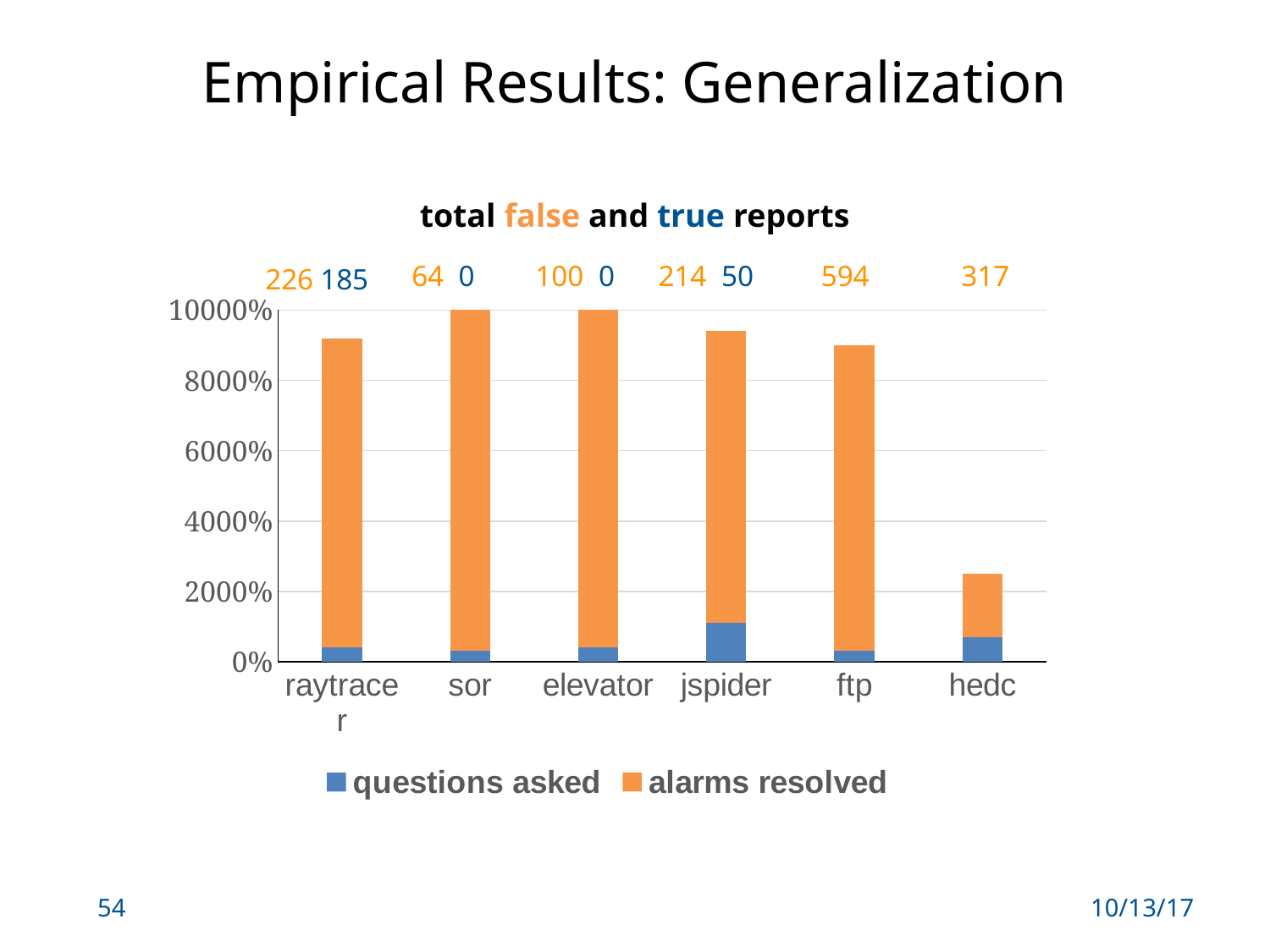
How many categories are shown on the x axis of the chart? 6 What number of false reports is printed above the raytracer bar? 226 What is the title of the chart? total false and true reports Which has the larger total bar, ftp or hedc? ftp Is the 'questions asked' segment for jspider greater or less than 2000%? less Which category has the lowest total bar in the chart? hedc Which has the larger 'questions asked' segment, jspider or raytracer? jspider Is the total bar for ftp greater or less than 8000%? greater Is the total bar for hedc greater or less than 4000%? less What kind of chart is shown on the slide? stacked bar chart What number of true reports is printed above the jspider bar? 50 How many series does the chart legend list? 2